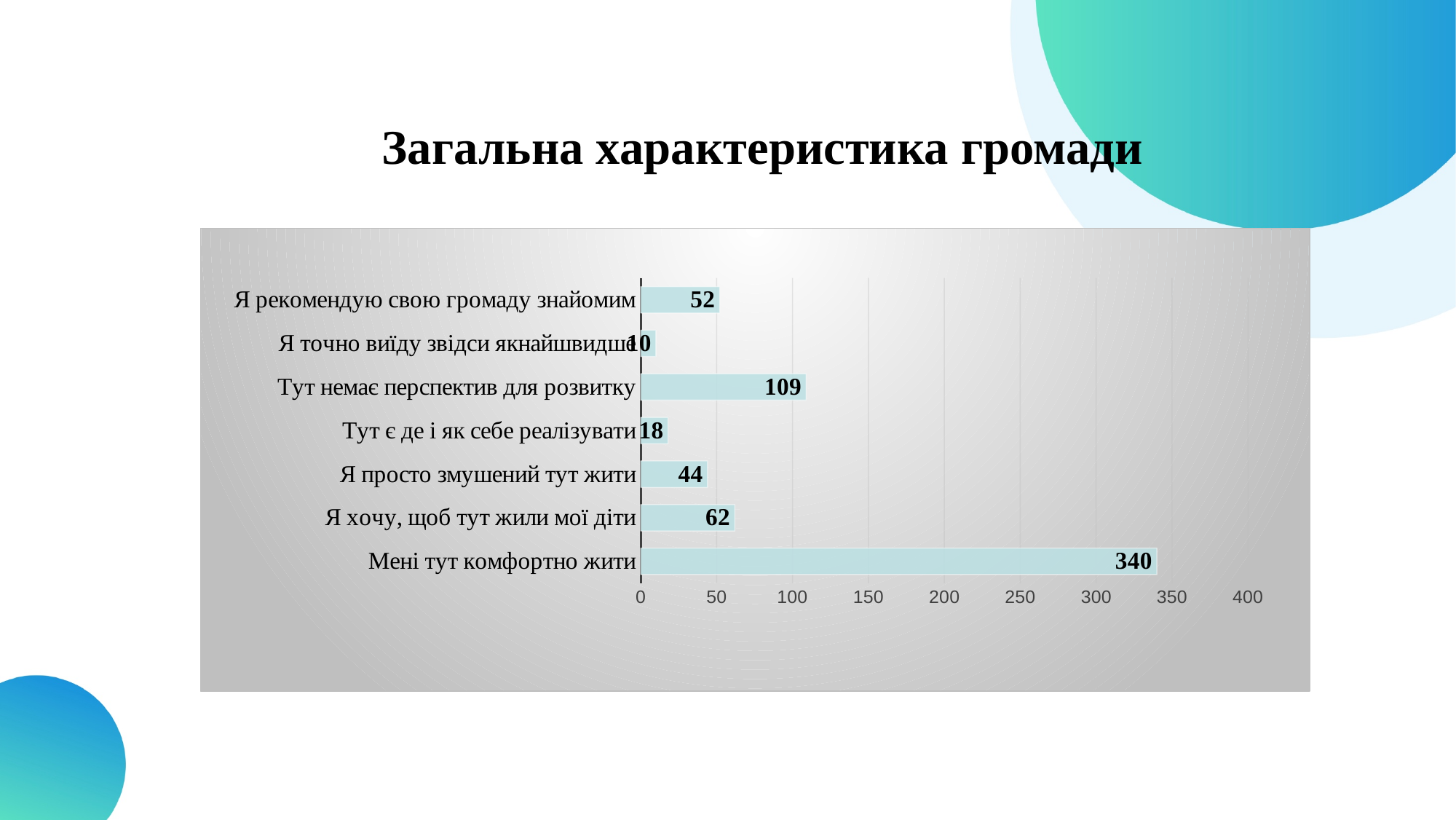
What is the value for "Тут є де і як себе реалізувати"? 18 Which is larger: the value for "Я хочу, щоб тут жили мої діти" or the value for "Я рекомендую свою громаду знайомим"? Я хочу, щоб тут жили мої діти What type of chart is shown on the slide? bar chart What is the value for "Я хочу, щоб тут жили мої діти"? 62 What is the value for "Тут немає перспектив для розвитку"? 109 How many categories are shown in the chart? 7 What is the title of the slide? Загальна характеристика громади What is the value for "Мені тут комфортно жити"? 340 What is the value for "Я просто змушений тут жити"? 44 Which category has the highest value? Мені тут комфортно жити What is the value for "Я рекомендую свою громаду знайомим"? 52 What is the difference between the values for "Мені тут комфортно жити" and "Тут немає перспектив для розвитку"? 231